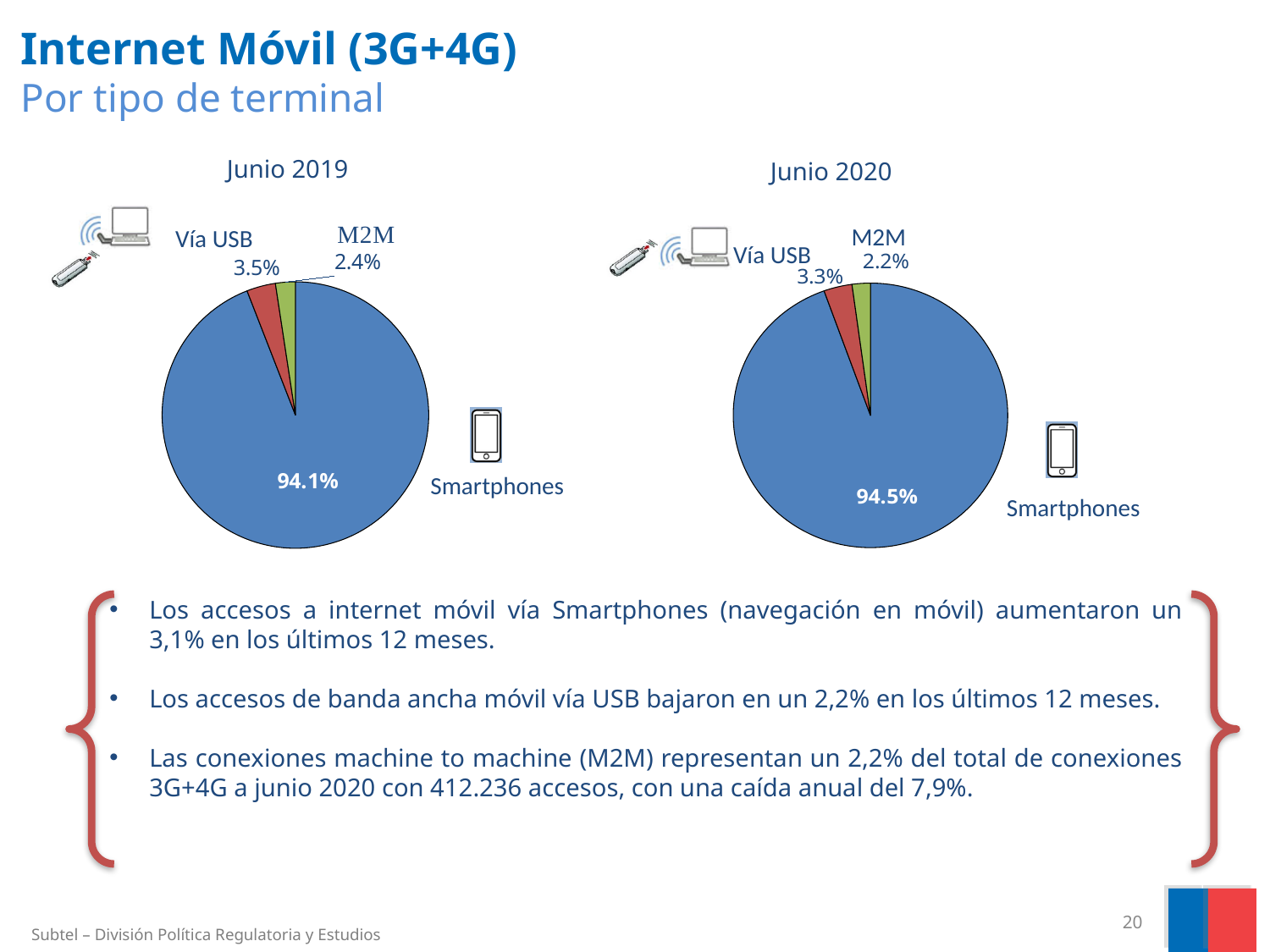
Which is larger: the Vía USB share in Junio 2019 or the Vía USB share in Junio 2020? Junio 2019 What type of chart is used for Junio 2019? Pie chart In the Junio 2020 pie chart, what colour is the Smartphones slice? Blue In the Junio 2020 pie chart, what is the difference between the Vía USB share and the M2M share? 1.1% In the Junio 2019 pie chart, which category has the smallest slice? M2M In the Junio 2020 pie chart, which category has the largest slice? Smartphones How many categories does the Junio 2020 pie chart show? 3 In the Junio 2019 pie chart, what is the difference between the Vía USB share and the M2M share? 1.1% In the Junio 2019 pie chart, what share do Smartphones have? 94.1% In the Junio 2020 pie chart, what is the value for M2M? 2.2% In the Junio 2020 pie chart, what share do Smartphones have? 94.5% In the Junio 2019 pie chart, what is the value for Vía USB? 3.5%